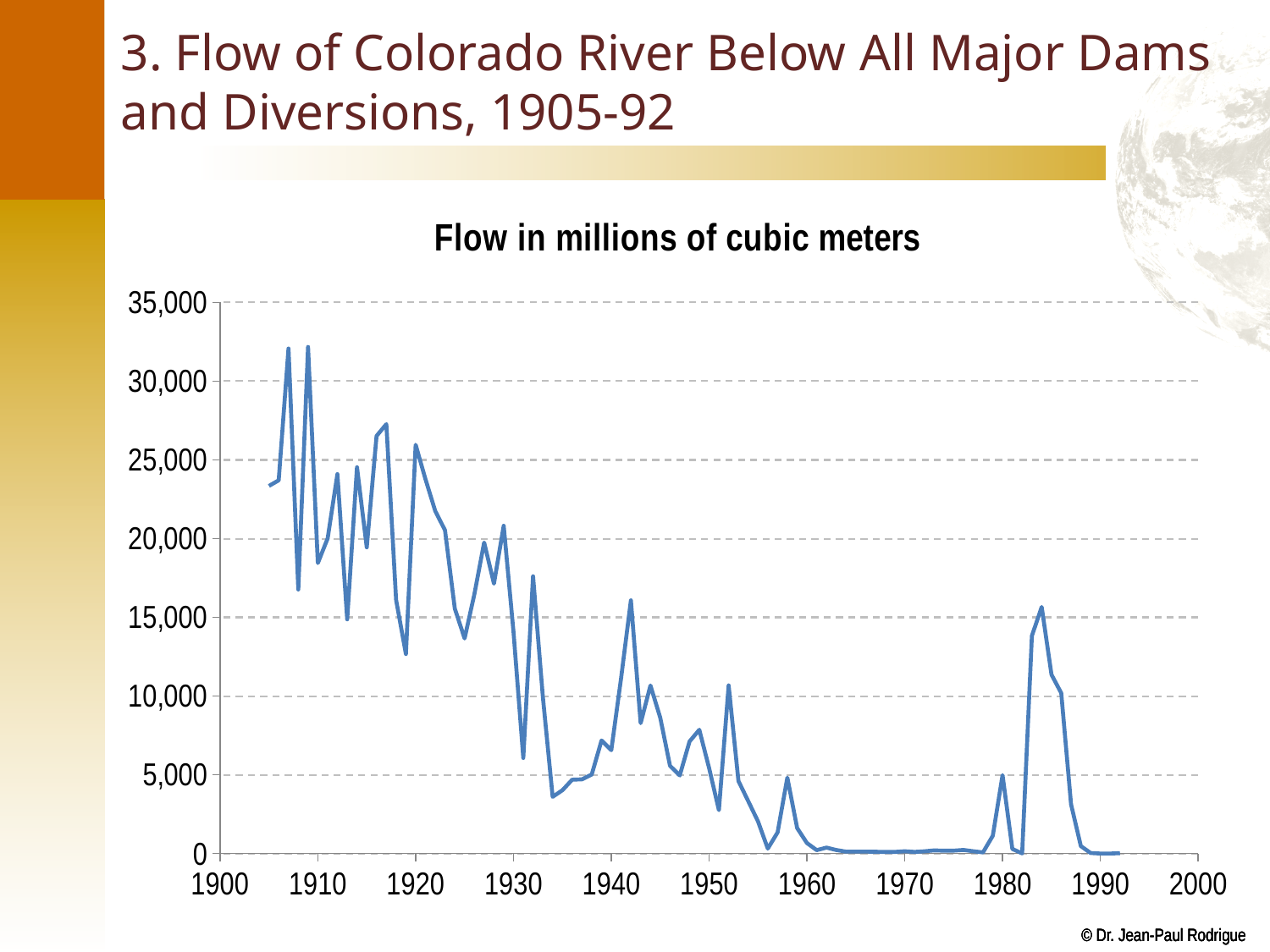
Is the flow value in 1907 greater or less than 30,000? greater Is the flow value in 1920 greater or less than 20,000? greater Is the flow value in 1942 greater or less than 10,000? greater What kind of chart is shown on the slide? line chart What is the title of the chart? Flow in millions of cubic meters What is the highest value labelled on the vertical axis? 35,000 How many data series are plotted on the chart? 1 Which year has the larger flow value, 1907 or 1990? 1907 Overall, do the flow values rise or fall from 1905 to 1992? fall